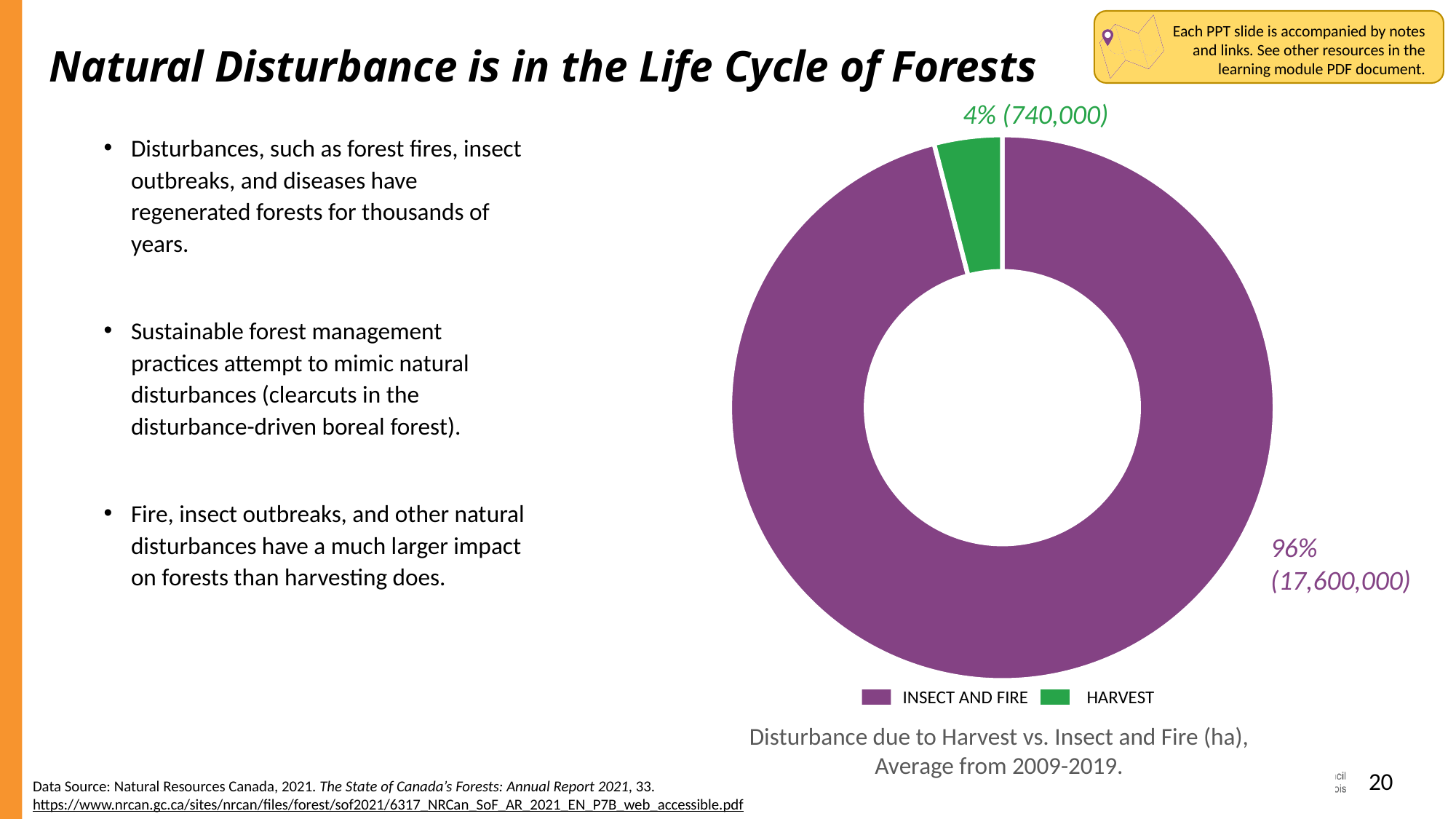
What kind of chart is shown on the slide? Pie chart (doughnut) What percentage of the disturbance is due to Insect and Fire? 96% What is the difference in percentage points between the Insect and Fire share and the Harvest share? 92 percentage points Which category has the smallest share of the chart? Harvest What colour represents Harvest in the chart? Green What percentage of the disturbance is due to Harvest? 4% How many categories does the chart show? 2 How many hectares are attributed to Insect and Fire in the chart? 17,600,000 Which category has the largest share of the chart? Insect and Fire What is the caption of the chart? Disturbance due to Harvest vs. Insect and Fire (ha), Average from 2009-2019. Which is larger, the share for Harvest or the share for Insect and Fire? Insect and Fire How many hectares are attributed to Harvest in the chart? 740,000